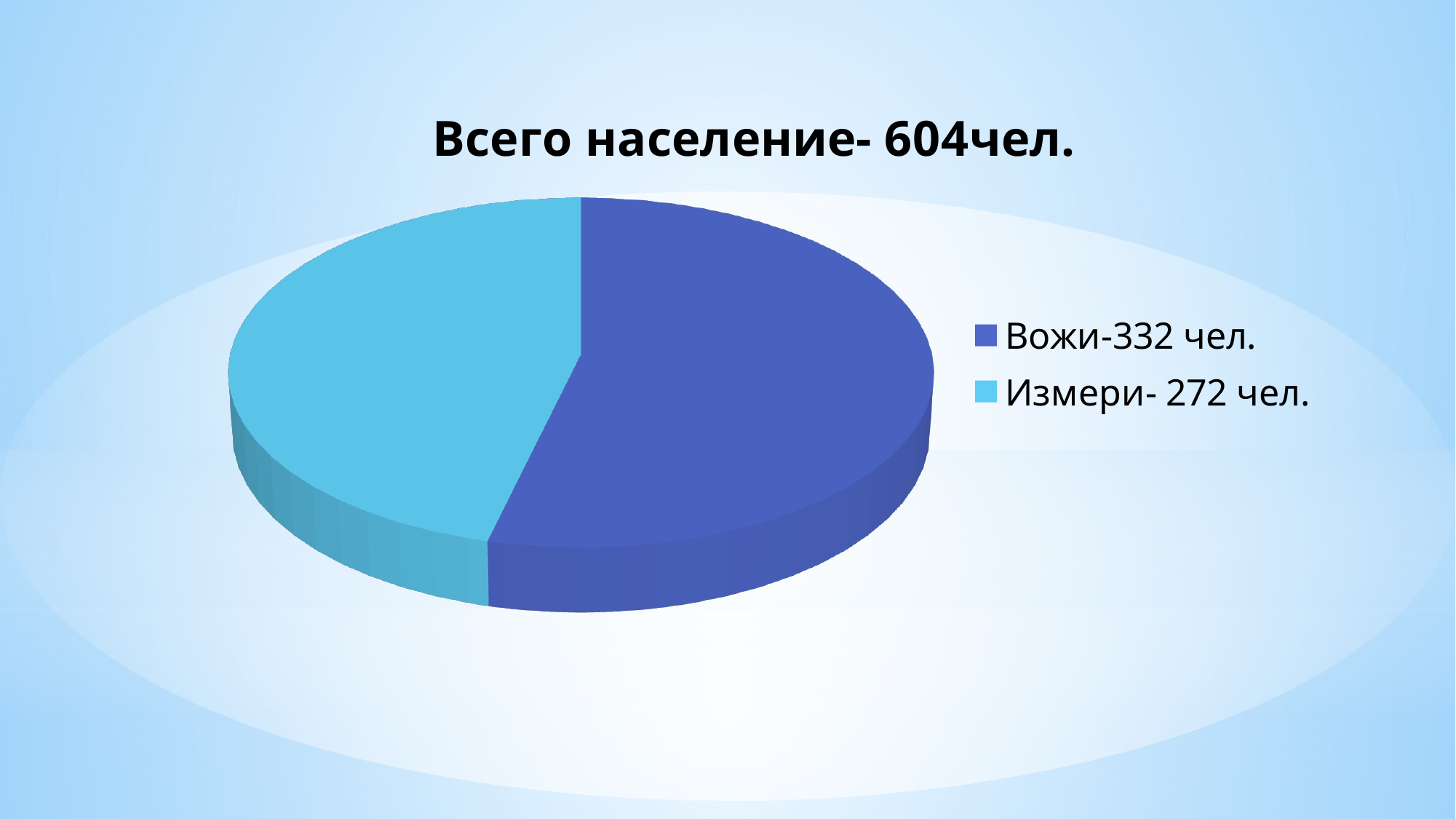
What is the population value for Вожи? 332 чел. What type of chart is shown on the slide? pie chart Which colour represents Измери in the pie chart? light blue Which slice is the largest? Вожи What is the chart's title? Всего население- 604чел. What is the difference between the values for Вожи and Измери? 60 чел. How many slices does the pie chart have? 2 What is the population value for Измери? 272 чел. How many entries does the legend list? 2 What is the total population shown in the chart title? 604 чел. Which slice is the smallest? Измери Which is larger, the value for Вожи or the value for Измери? Вожи